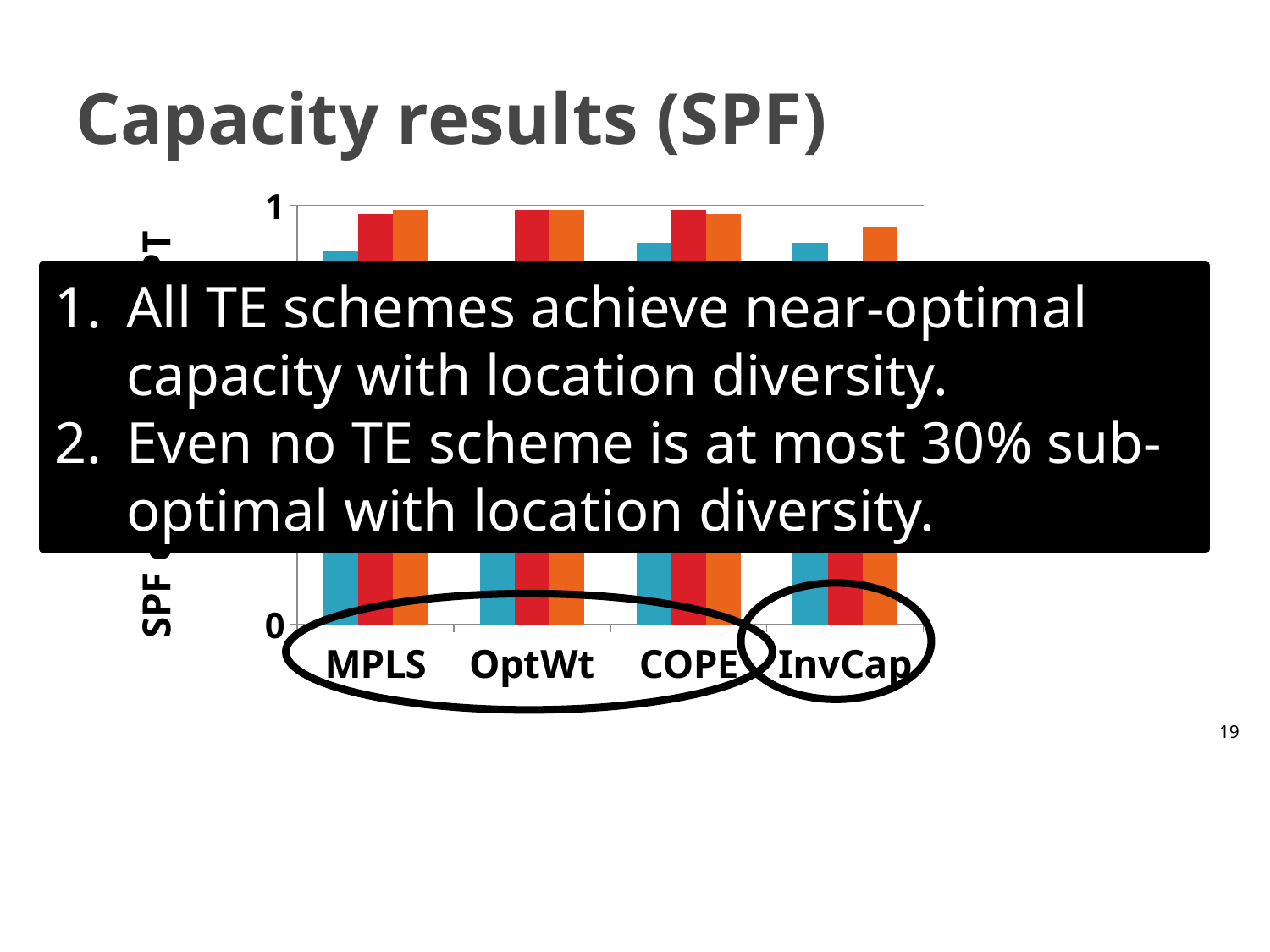
How many bars are plotted for each category in the chart? 3 For the MPLS category, which is larger, the blue bar or the red bar? red For the COPE category, which is larger, the blue bar or the red bar? red Is the value of the blue bar for InvCap greater or less than 1? less What is the title of the slide containing the chart? Capacity results (SPF) For the InvCap category, which is larger, the blue bar or the orange bar? orange Which categories are listed along the x axis of the chart? MPLS, OptWt, COPE, InvCap What kind of chart is shown on the slide? bar chart How many categories are shown on the x axis of the chart? 4 Which category has the lowest blue bar in the chart? OptWt For the MPLS category, which bar is the lowest: blue, red or orange? blue